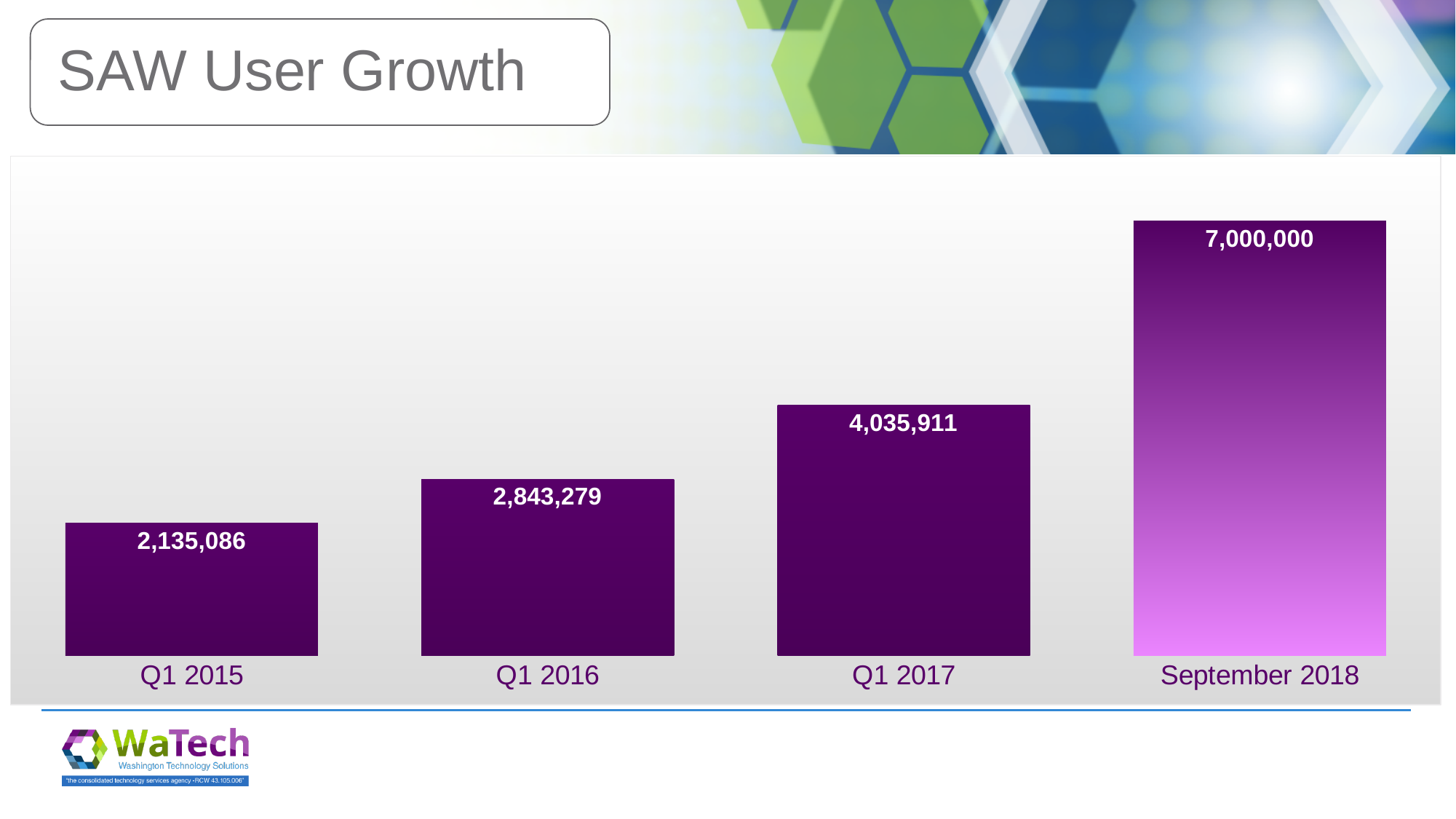
What is the value for Q1 2015? 2,135,086 Which category has the highest value? September 2018 What is the difference between the values for September 2018 and Q1 2015? 4,864,914 Which is larger, the value for Q1 2016 or the value for Q1 2017? Q1 2017 What is the value for September 2018? 7,000,000 Do the values rise or fall from Q1 2015 to September 2018? Rise How many categories are shown on the chart? 4 What is the value for Q1 2016? 2,843,279 What kind of chart is shown on the slide? Bar chart Which category has the lowest value? Q1 2015 What is the value for Q1 2017? 4,035,911 What is the difference between the values for Q1 2017 and Q1 2016? 1,192,632